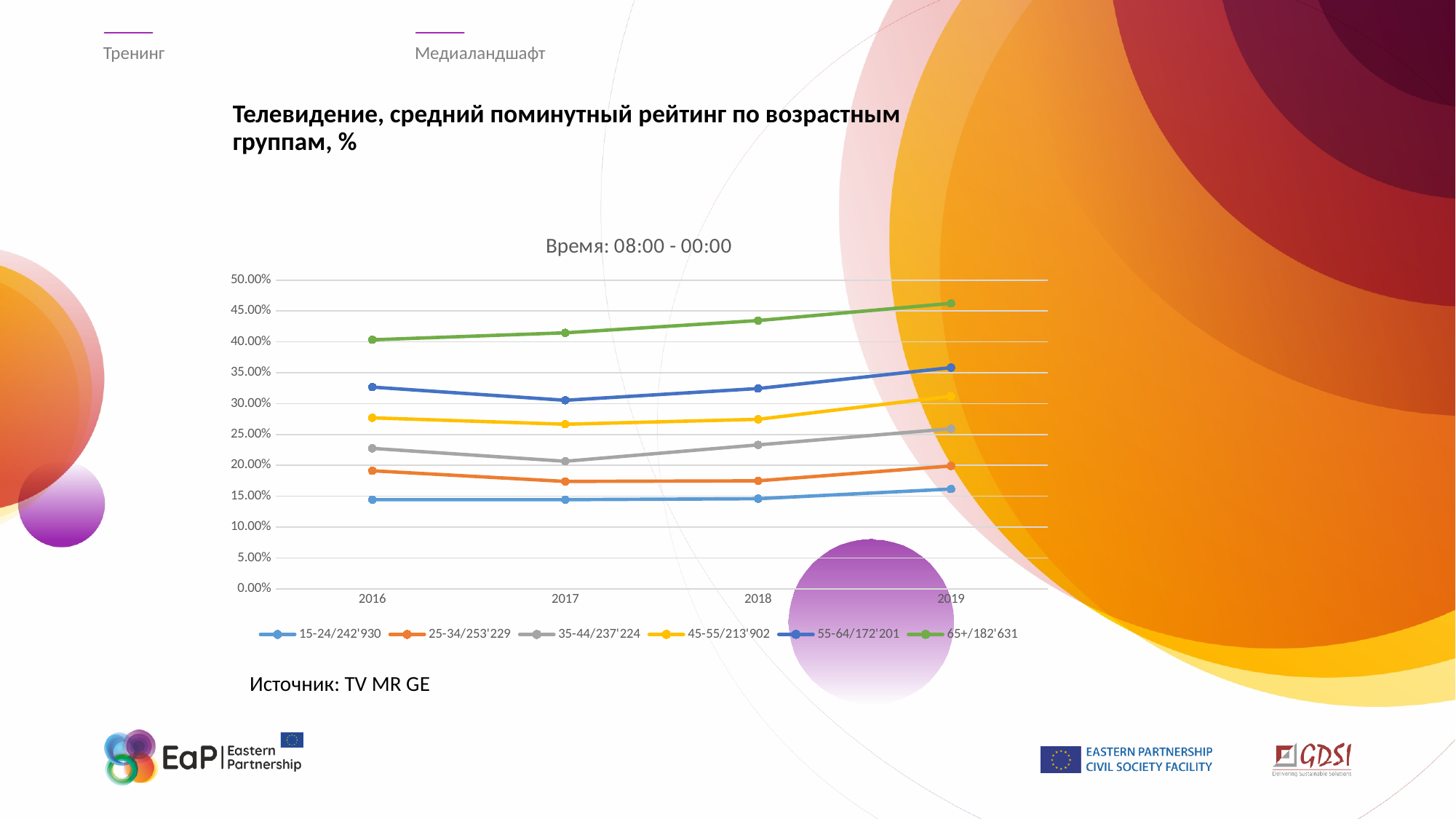
Is the value for the 25-34/253'229 group in 2017 greater or less than 20.00%? less What time period is given in the chart's subtitle? 08:00 - 00:00 Is the value for the 55-64/172'201 group in 2016 greater or less than 30.00%? greater How many series does the legend list? 6 What kind of chart is shown on the slide? line chart In 2016, which is larger: the rating for 55-64/172'201 or for 45-55/213'902? 55-64/172'201 How many years are shown on the x axis? 4 Is the value for the 65+/182'631 group in 2018 greater or less than 40.00%? greater Which age group has the highest rating in every year shown? 65+/182'631 Does the rating for the 65+/182'631 group rise or fall from 2016 to 2019? rise Which age group has the lowest rating in every year shown? 15-24/242'930